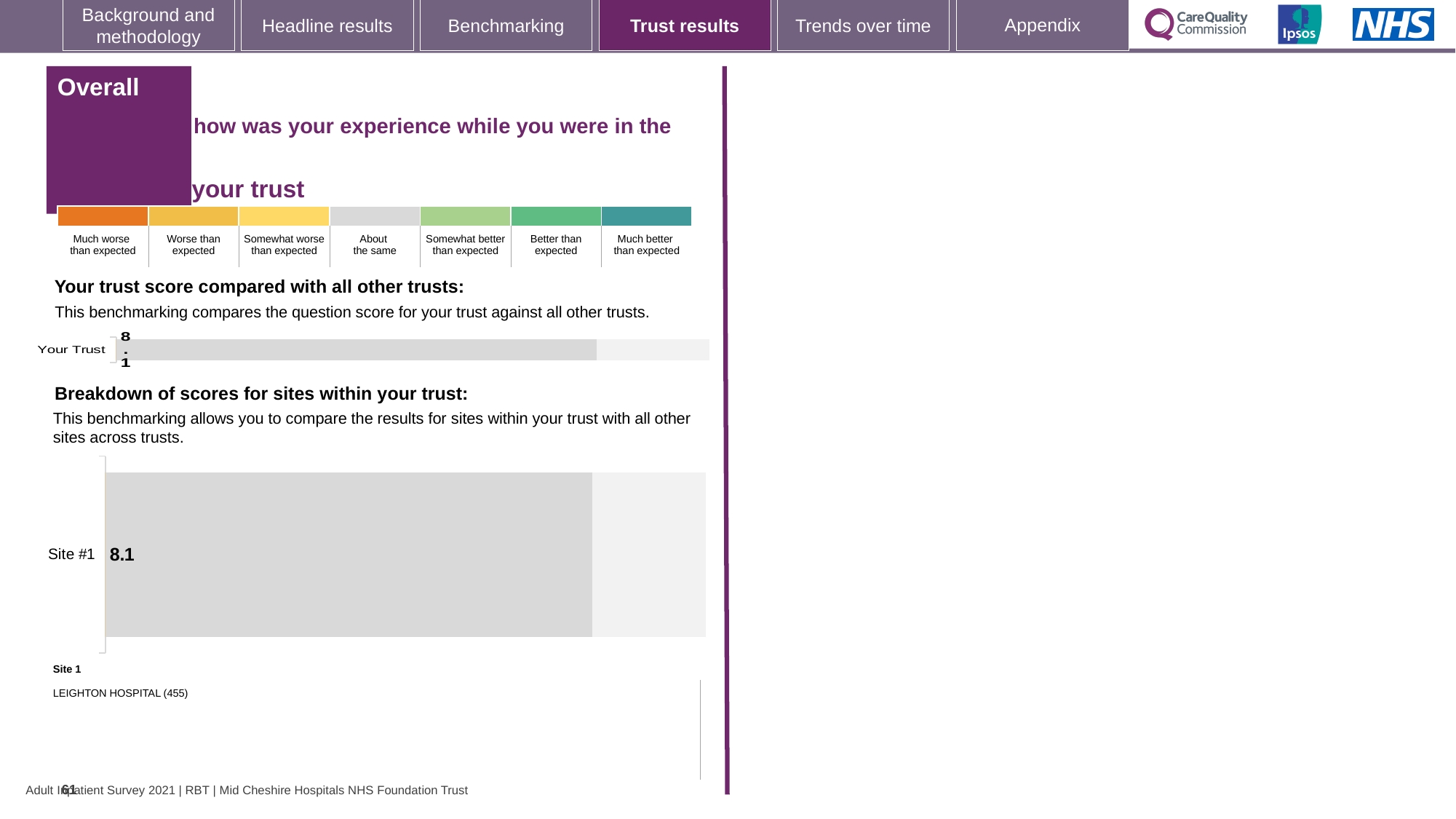
In the 'Breakdown of scores for sites within your trust' chart, what is the score for Site #1? 8.1 In the 'Your trust score compared with all other trusts' chart, what is the score for Your Trust? 8.1 How many rating categories are shown in the colour scale above the charts, from 'Much worse than expected' to 'Much better than expected'? 7 What is the difference between the Site #1 score in the breakdown chart and the Your Trust score in the trust comparison chart? 0 What kind of chart is used in the 'Breakdown of scores for sites within your trust' section? Bar chart Is the score for Site #1 in the breakdown chart higher than, lower than, or the same as the Your Trust score in the trust comparison chart? The same How many sites are plotted in the 'Breakdown of scores for sites within your trust' chart? 1 Which hospital is listed as Site 1 below the breakdown chart? LEIGHTON HOSPITAL (455) How many bars are plotted in the 'Your trust score compared with all other trusts' chart? 1